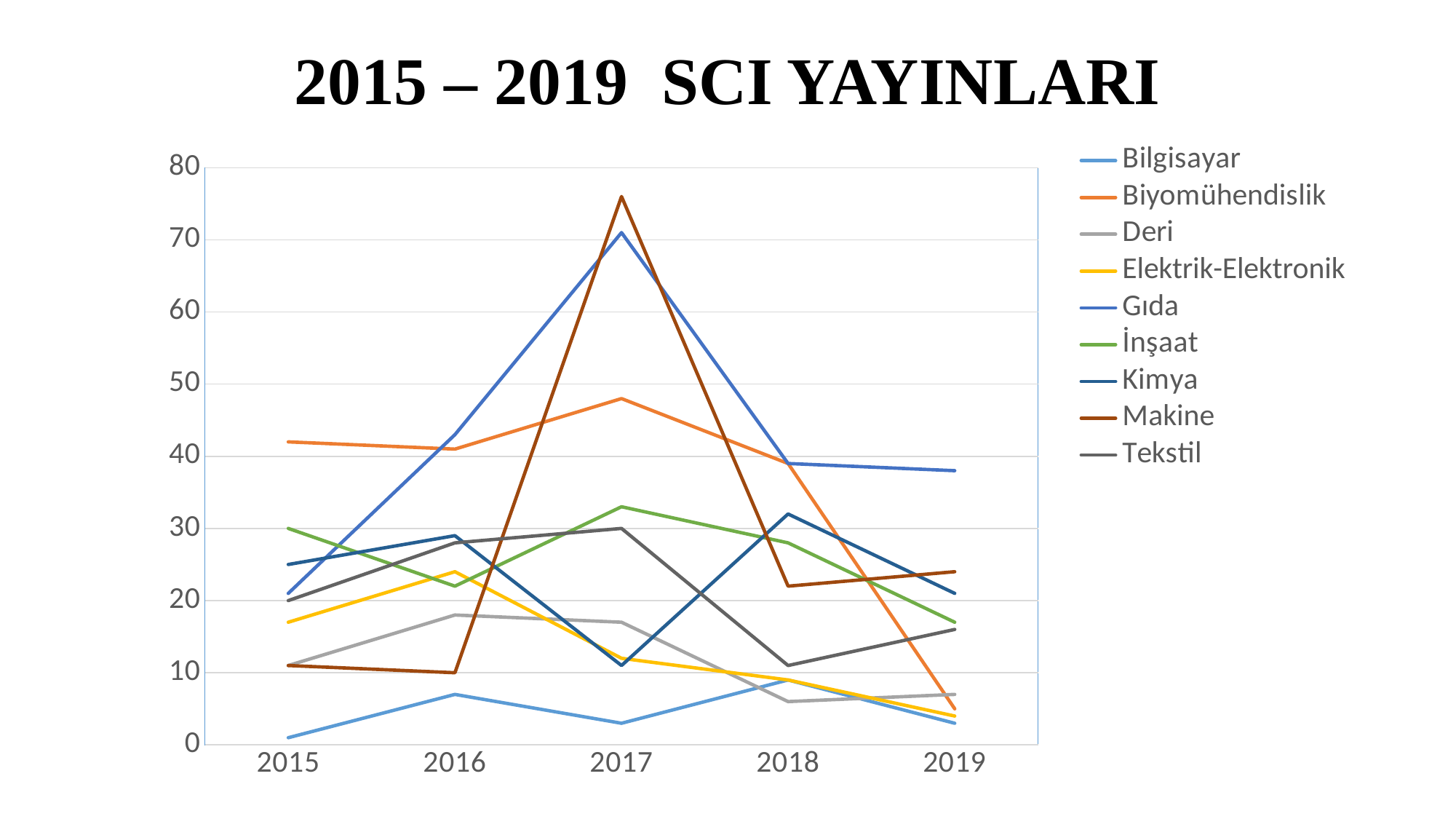
How many series does the legend list? 9 Which series has the highest value in 2017? Makine What kind of chart is shown on the slide? line chart In 2019, which is larger: the value for Gıda or the value for İnşaat? Gıda What is the title of the chart? 2015 – 2019 SCI YAYINLARI Which series has the lowest value in 2015? Bilgisayar Is the value for Bilgisayar in 2015 greater or less than 10? less Does the Biyomühendislik line rise or fall from 2018 to 2019? fall Is the value for Gıda in 2017 greater or less than 60? greater Which series has the highest value in 2015? Biyomühendislik How many years are shown on the x axis? 5 Is the value for Makine in 2017 greater or less than 70? greater